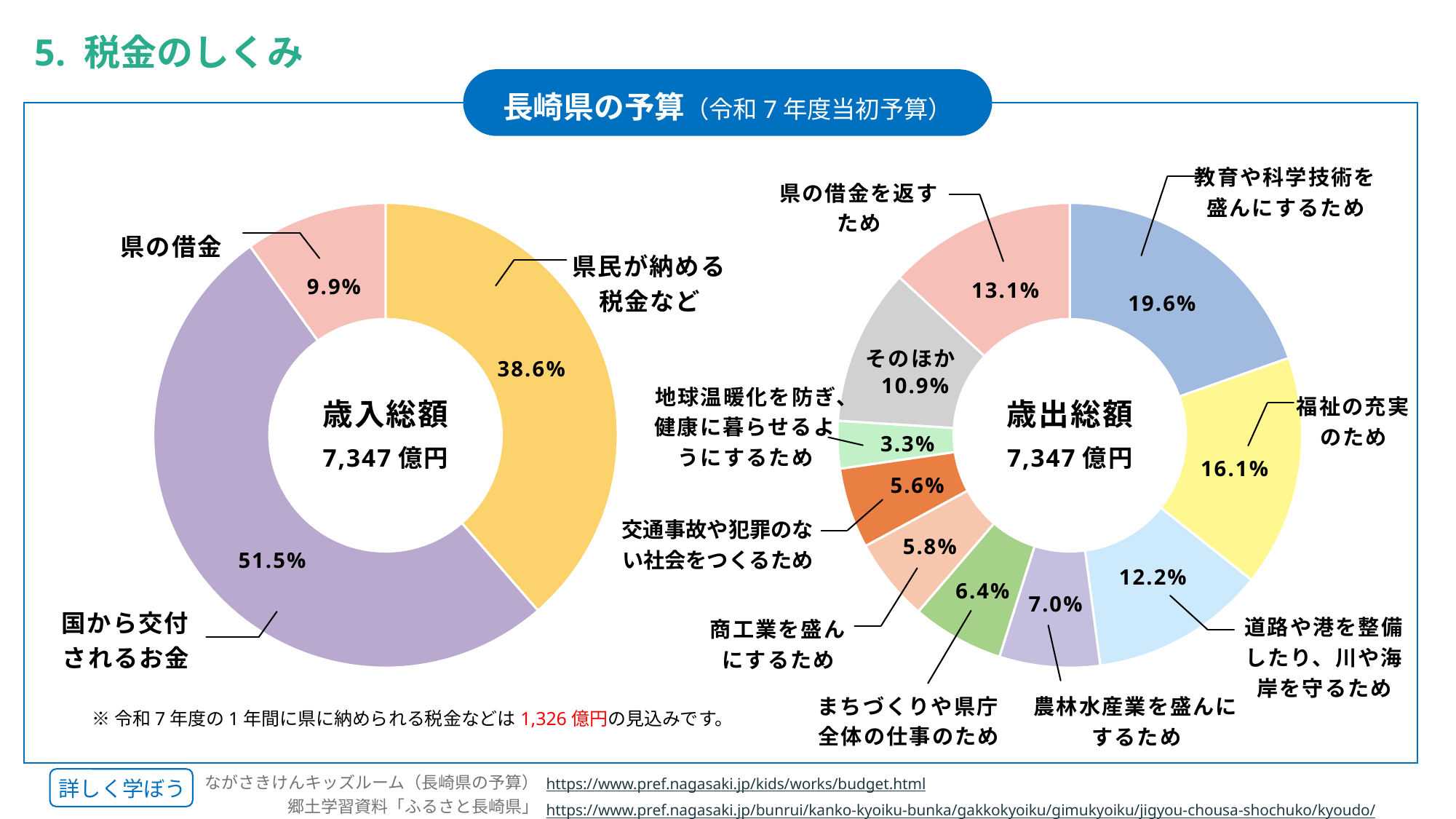
「歳出総額」のグラフには、いくつの項目がありますか？ 10 「歳入総額」のグラフには、いくつの項目がありますか？ 3 「歳入総額」のグラフで、「国から交付されるお金」と「県民が納める税金など」の割合の差は何ポイントですか？ 12.9ポイント 「歳出総額」のグラフで、「福祉の充実のため」の割合は何%ですか？ 16.1% 「歳入総額」のグラフで、「国から交付されるお金」の割合は何%ですか？ 51.5% このスライドのグラフはどのような種類のグラフですか？ 円グラフ（ドーナツグラフ） 「歳入総額」のグラフで、最も割合が大きい項目はどれですか？ 国から交付されるお金 「歳出総額」のグラフで、「農林水産業を盛んにするため」の割合は何%ですか？ 7.0% 「歳出総額」のグラフで、最も割合が小さい項目はどれですか？ 地球温暖化を防ぎ、健康に暮らせるようにするため 「歳入総額」のグラフで、「県の借金」の割合は何%ですか？ 9.9% 「歳出総額」のグラフで、「県の借金を返すため」と「道路や港を整備したり、川や海岸を守るため」では、どちらの割合が大きいですか？ 県の借金を返すため 「歳出総額」のグラフで、最も割合が大きい項目はどれですか？ 教育や科学技術を盛んにするため